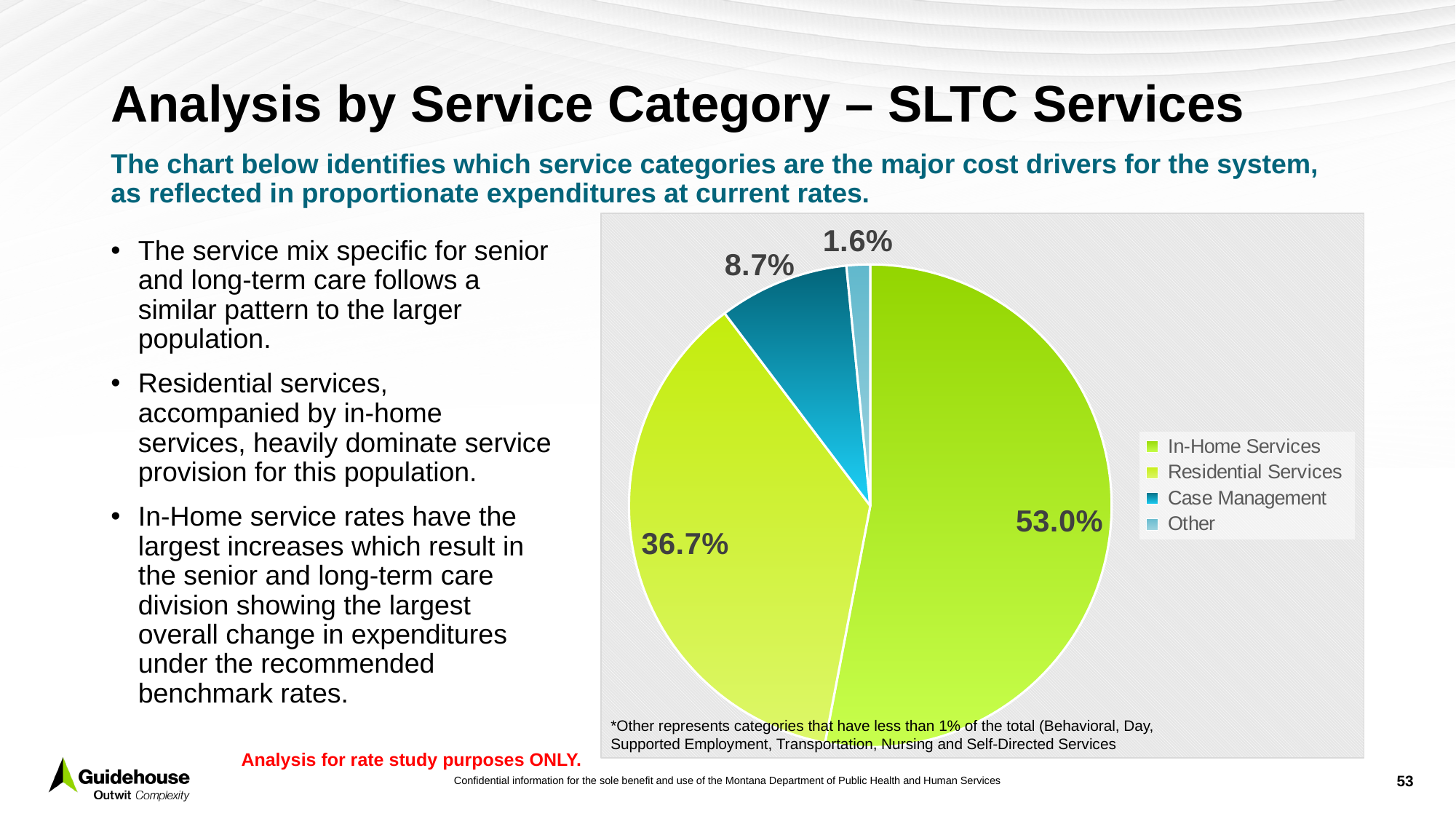
How many categories does the pie chart show? 4 What is the combined share of Case Management and Other? 10.3% What is the difference between the In-Home Services share and the Residential Services share? 16.3% Which is larger, the Case Management slice or the Other slice? Case Management What is the value shown for Case Management? 8.7% What is the value shown for the Other slice? 1.6% Which category has the largest slice of the pie? In-Home Services Which category has the smallest slice of the pie? Other What share of the pie does In-Home Services represent? 53.0% What kind of chart is shown on the slide? pie chart Which legend entry is shown in the darkest blue colour? Case Management What share of the pie does Residential Services represent? 36.7%